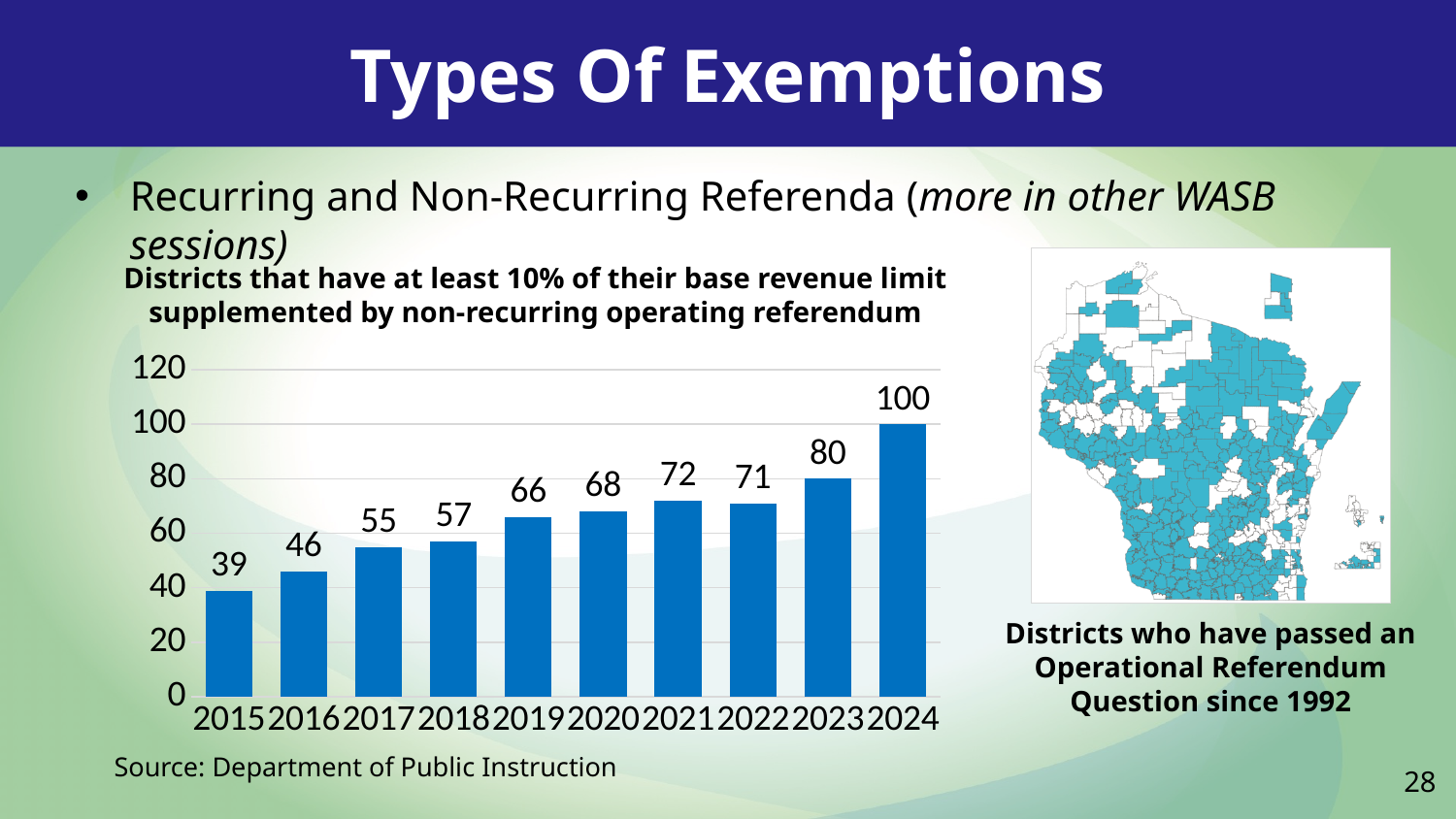
Which year has the highest value in the bar chart? 2024 What is the difference between the values for 2024 and 2015? 61 How many years are shown on the x axis of the bar chart? 10 What kind of chart is used to show districts with at least 10% of their base revenue limit supplemented by non-recurring operating referendum? Bar chart Is the value for 2019 greater or less than 60? greater What is the value for 2023 in the bar chart? 80 What is the source cited below the bar chart? Department of Public Instruction What is the value for 2015 in the bar chart? 39 What is the difference between the values for 2023 and 2022? 9 What is the value for 2020 in the bar chart? 68 Which is larger, the value for 2021 or the value for 2022? 2021 Which year has the lowest value in the bar chart? 2015